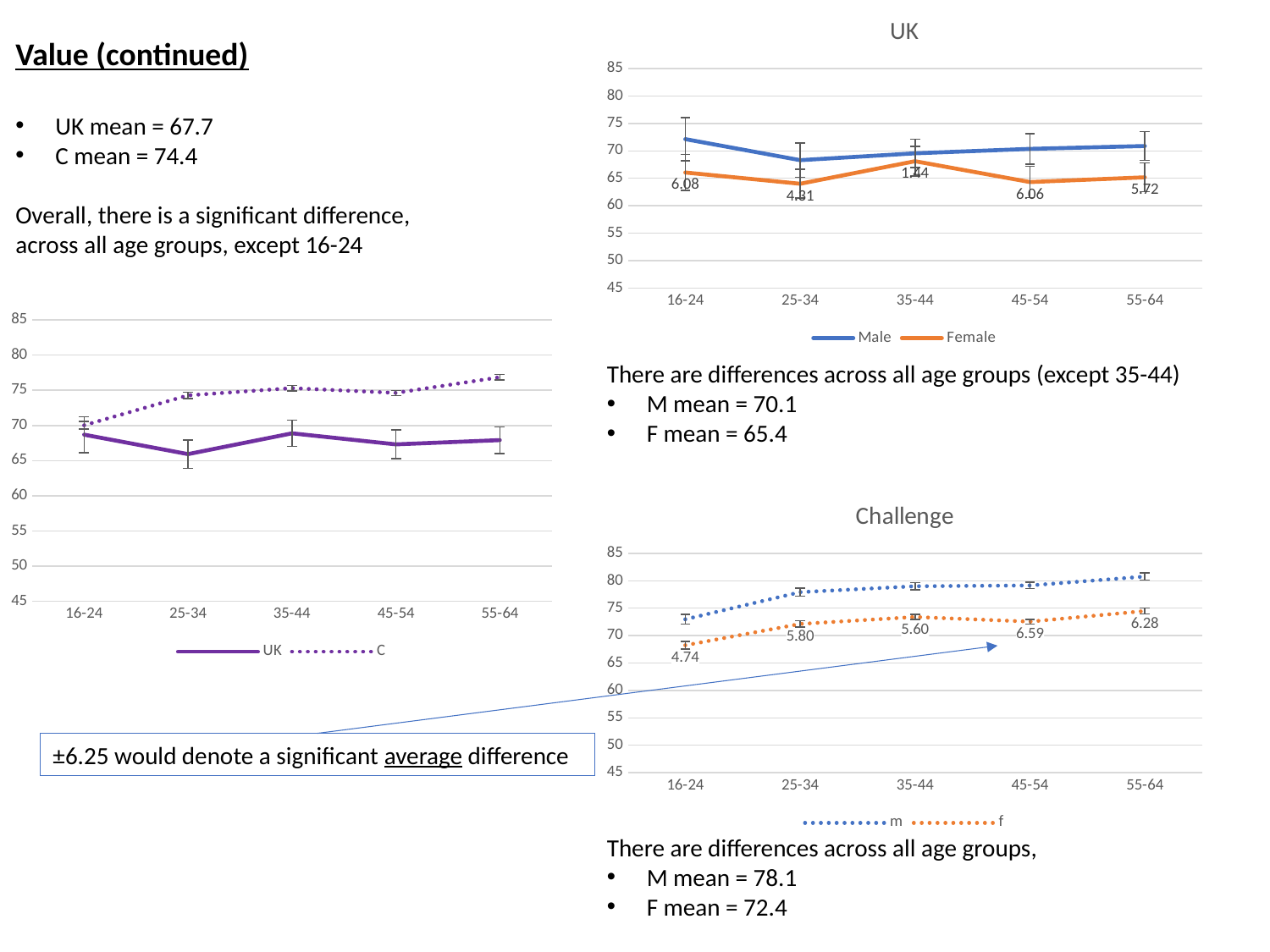
On the chart on the left of the slide, at which age group is the C series highest? 55-64 On the chart titled "UK", at which age group is the Female series highest? 35-44 On the chart titled "Challenge", do the values for the m series generally rise or fall from 16-24 to 55-64? rise On the chart titled "UK", is the value for Female at 25-34 greater or less than 65? less On the chart on the left of the slide, how many age-group categories are on the x axis? 5 On the chart titled "UK", what kind of chart is shown? line chart On the chart titled "Challenge", how many series does the legend list? 2 On the chart on the left of the slide, is the value for C at 55-64 greater or less than 75? greater On the chart titled "Challenge", at which age group is the f series lowest? 16-24 On the chart on the left of the slide, which series has the higher value at 35-44, UK or C? C On the chart on the left of the slide, at which age group is the UK series lowest? 25-34